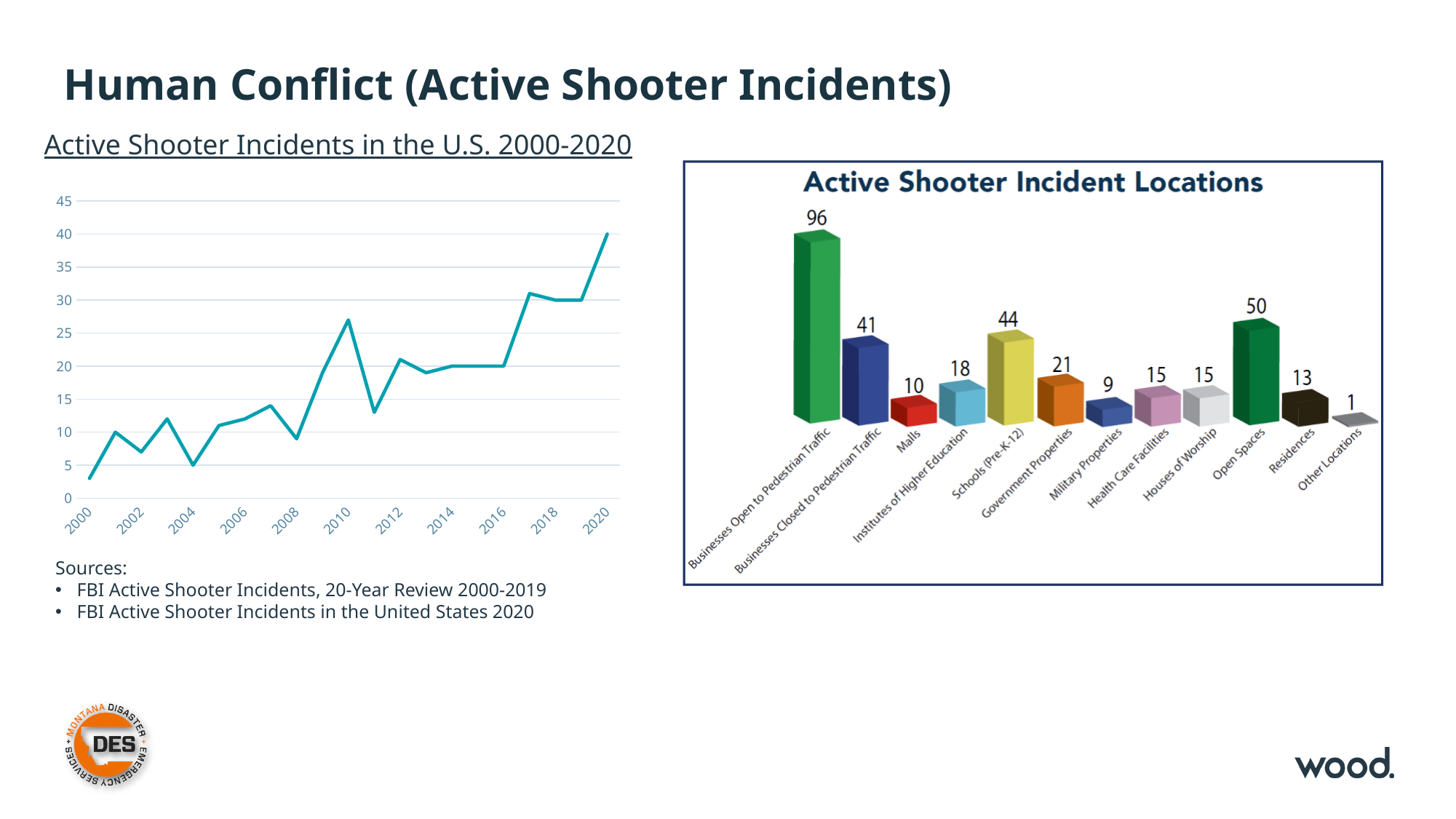
In the Active Shooter Incident Locations chart, which location has the lowest number of incidents? Other Locations In the Active Shooter Incident Locations chart, which is larger: Open Spaces or Schools (Pre-K-12)? Open Spaces What kind of chart is the Active Shooter Incidents in the U.S. 2000-2020 chart? Line chart In the Active Shooter Incident Locations chart, what is the difference between Businesses Open to Pedestrian Traffic and Businesses Closed to Pedestrian Traffic? 55 How many location categories are shown in the Active Shooter Incident Locations chart? 12 In the Active Shooter Incident Locations chart, which location has the highest number of incidents? Businesses Open to Pedestrian Traffic In the Active Shooter Incident Locations chart, how many incidents occurred at Businesses Open to Pedestrian Traffic? 96 In the Active Shooter Incidents in the U.S. 2000-2020 chart, do the values generally rise or fall from 2000 to 2020? Rise In the Active Shooter Incident Locations chart, what is the value for Schools (Pre-K-12)? 44 In the Active Shooter Incident Locations chart, what is the value for Government Properties? 21 In the Active Shooter Incidents in the U.S. 2000-2020 chart, is the value for 2000 greater or less than 5? less In the Active Shooter Incidents in the U.S. 2000-2020 chart, is the value for 2010 greater or less than 25? greater